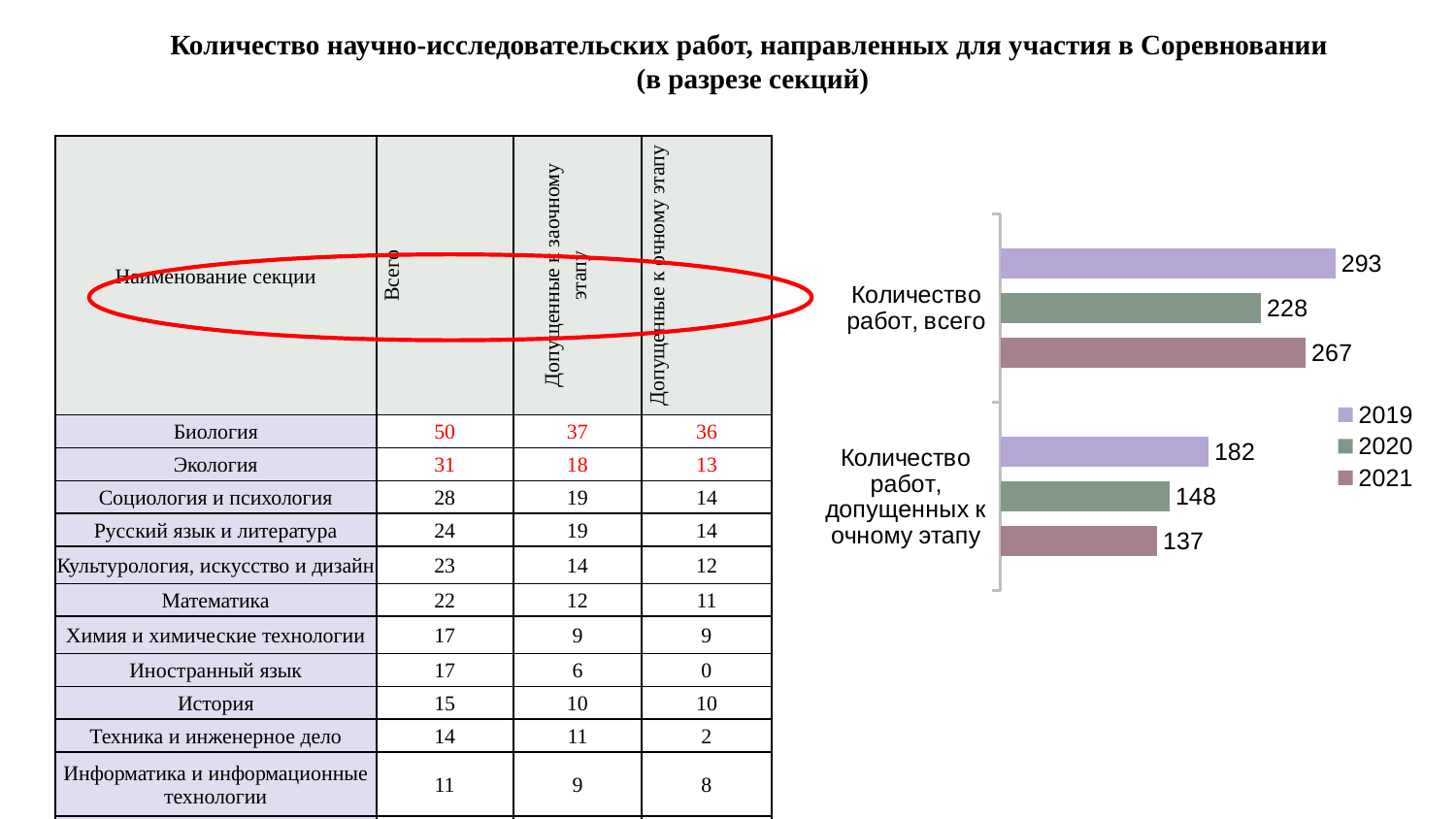
What is the difference between the 2019 and 2020 values in the 'Количество работ, допущенных к очному этапу' group? 34 What is the value for 2020 in the 'Количество работ, всего' group? 228 Which legend entry is shown in purple on the chart? 2019 Which is larger: the 2020 value or the 2021 value in the 'Количество работ, всего' group? 2021 What is the value for 2021 in the 'Количество работ, допущенных к очному этапу' group? 137 How many category groups are shown on the chart? 2 What is the value for 2019 in the 'Количество работ, всего' group? 293 What is the difference between the 2019 and 2021 values in the 'Количество работ, всего' group? 26 Which year has the highest value in the 'Количество работ, всего' group? 2019 What type of chart is shown on the right of the slide? bar chart How many series does the chart legend list? 3 Which year has the lowest value in the 'Количество работ, допущенных к очному этапу' group? 2021